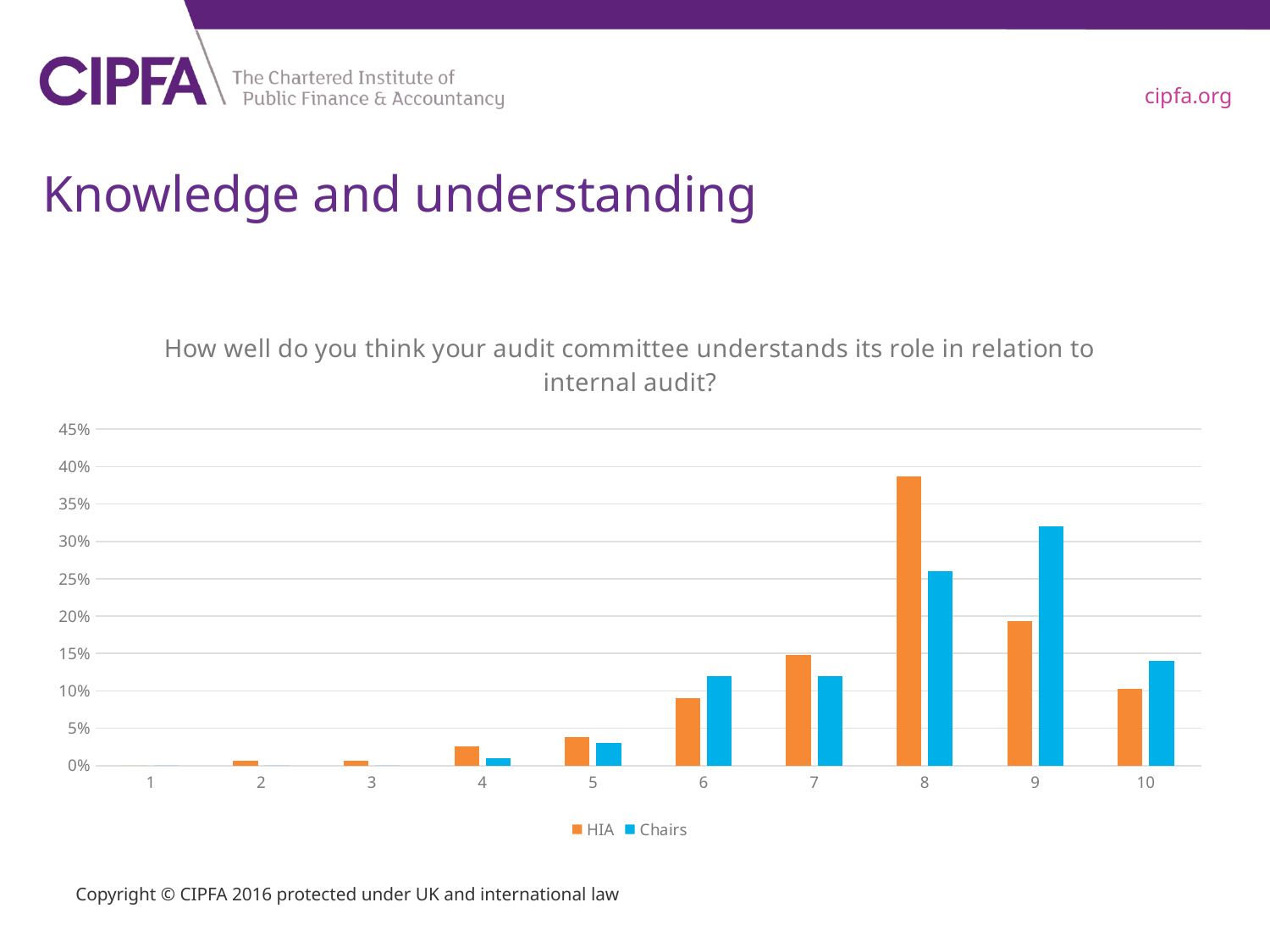
Is the HIA value for rating 8 greater or less than 35%? greater How many rating categories are shown on the x axis? 10 Which rating has the highest value for the Chairs series? 9 Which rating has the highest value for the HIA series? 8 At rating 8, which series has the larger value, HIA or Chairs? HIA What kind of chart is shown on the slide? bar chart How many series does the legend list? 2 What are the two series named in the legend? HIA and Chairs At rating 9, which series has the larger value, HIA or Chairs? Chairs At rating 10, which series has the larger value, HIA or Chairs? Chairs Is the HIA value for rating 7 greater or less than 20%? less Is the Chairs value for rating 9 greater or less than 30%? greater